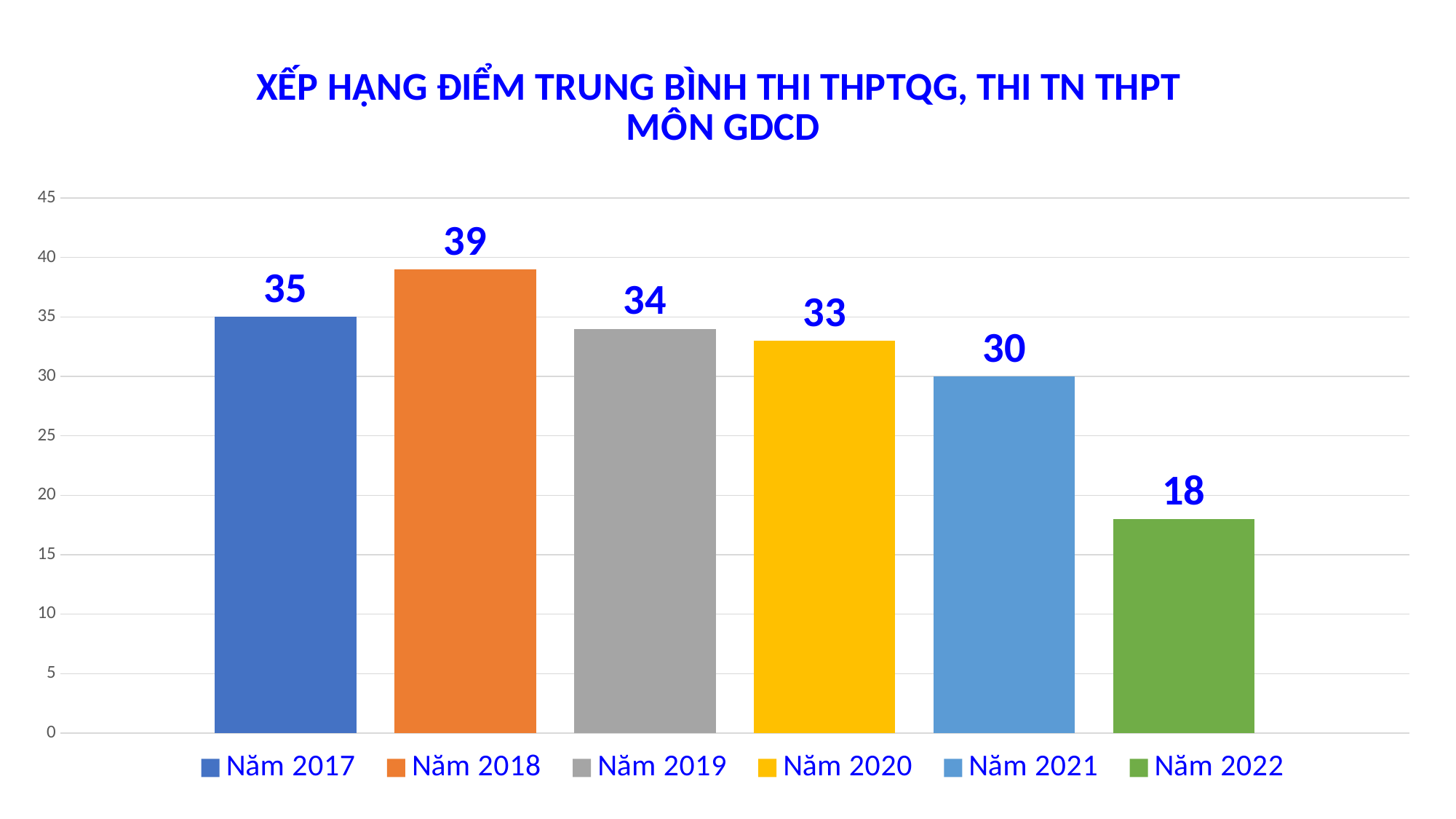
What is the difference between the values for Năm 2018 and Năm 2022? 21 Which year has the lowest value? Năm 2022 How many years are shown in the chart? 6 What is the difference between the values for Năm 2017 and Năm 2021? 5 Do the values rise or fall from Năm 2018 to Năm 2022? fall What is the value for Năm 2020? 33 Which year has the highest value? Năm 2018 Which is larger, the value for Năm 2019 or the value for Năm 2021? Năm 2019 Is the value for Năm 2021 greater or less than 25? greater What kind of chart is shown on the slide? bar chart What is the value for Năm 2022? 18 What is the value for Năm 2017? 35